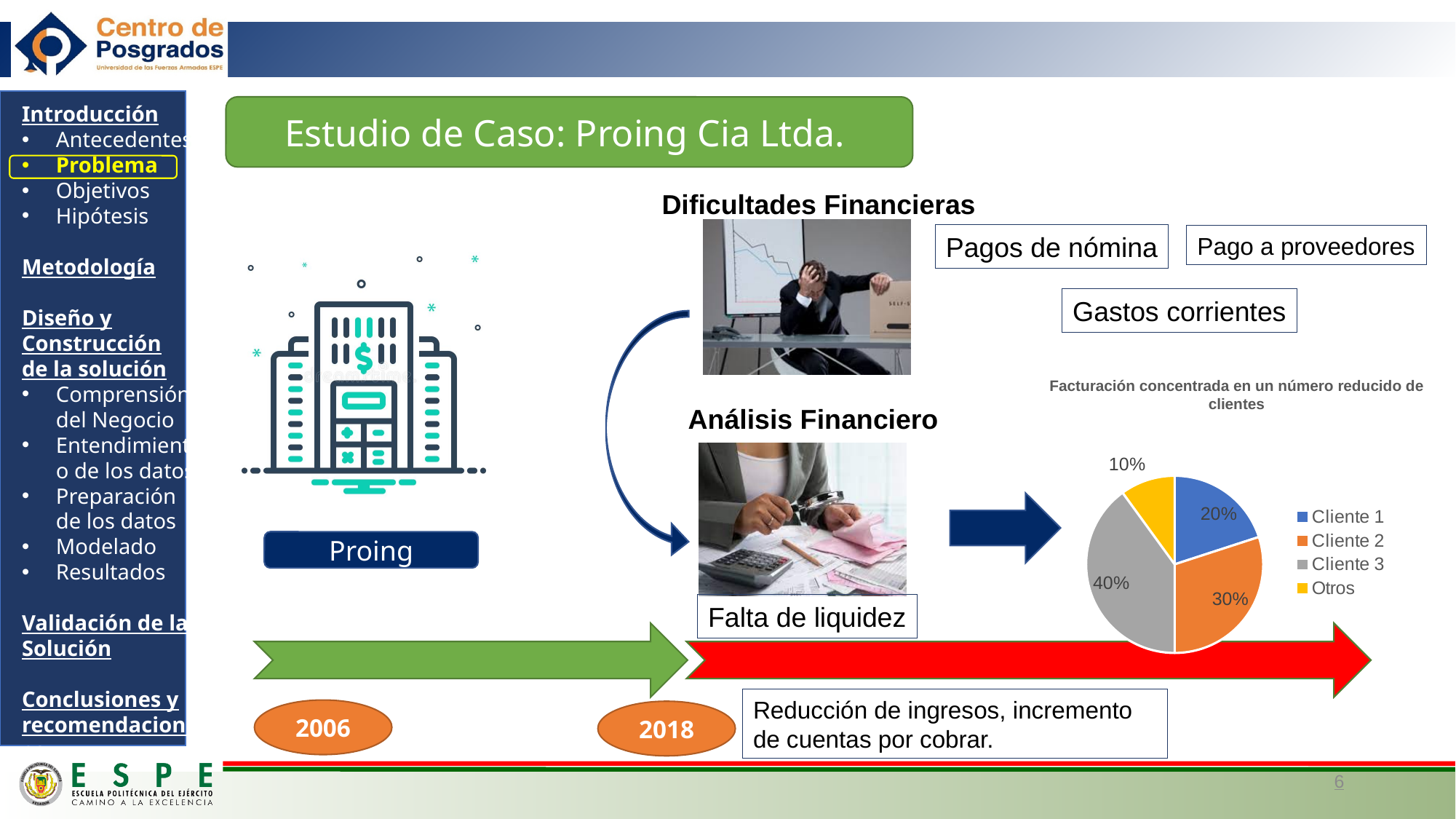
Which is larger, the share of Cliente 2 or the share of Otros? Cliente 2 What share of the pie does Otros represent? 10% What type of chart is shown on the slide? pie chart What colour is the slice for Cliente 3 in the pie chart? gray How many categories does the pie chart legend list? 4 Which category has the smallest slice of the pie? Otros What is the title of the pie chart? Facturación concentrada en un número reducido de clientes Which category has the largest slice of the pie? Cliente 3 What share of the pie does Cliente 2 represent? 30% What share of the pie does Cliente 1 represent? 20% What share of the pie does Cliente 3 represent? 40% What is the difference between the shares of Cliente 3 and Cliente 1? 20%